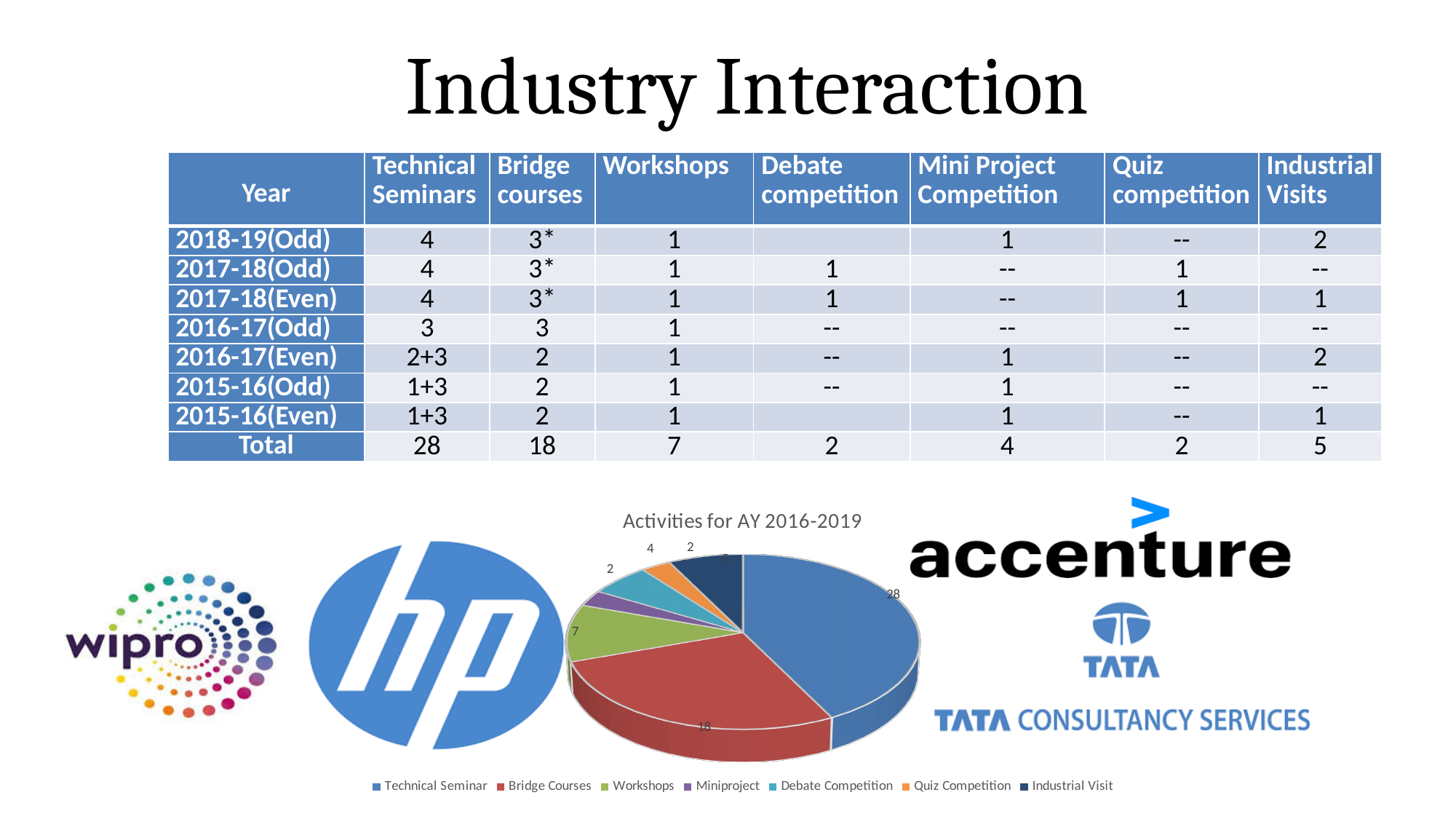
In the pie chart, which is larger: Workshops or Industrial Visit? Workshops What colour is the Bridge Courses slice in the pie chart? red In the pie chart, what is the value for Workshops? 7 How many categories does the pie chart's legend list? 7 What is the title of the pie chart? Activities for AY 2016-2019 In the pie chart, what is the difference between the values for Bridge Courses and Workshops? 11 In the pie chart, what is the value for Industrial Visit? 5 What kind of chart is shown on the slide? pie chart Which category has the largest slice in the pie chart? Technical Seminar In the pie chart, what is the difference between the values for Technical Seminar and Bridge Courses? 10 In the pie chart, what is the value for Bridge Courses? 18 In the pie chart, what is the value for Technical Seminar? 28